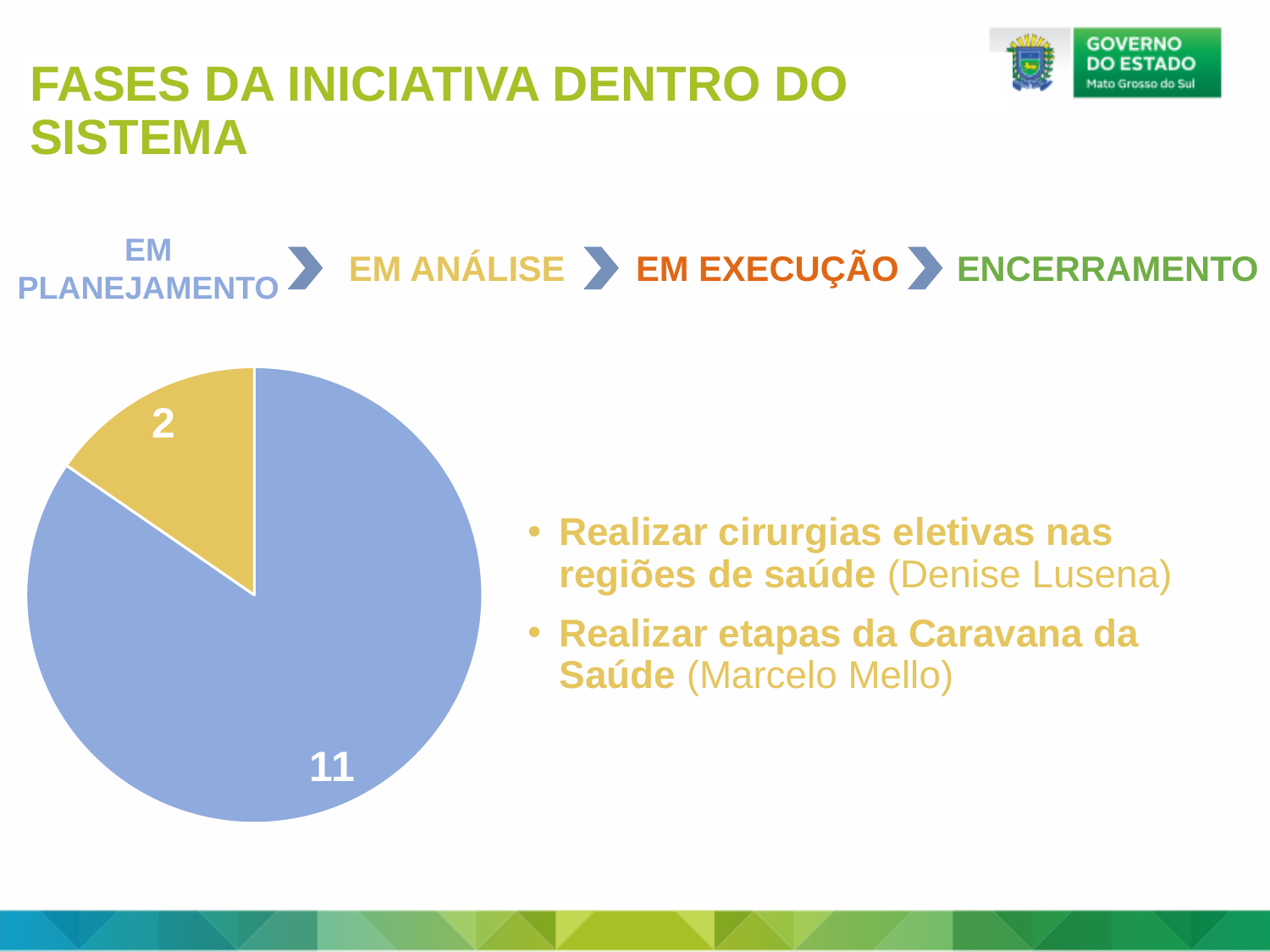
What value is printed on the blue slice of the pie chart? 11 Which slice of the pie chart is the largest? the blue slice (11) Which is larger, the blue slice or the yellow slice? the blue slice What is the difference between the values of the blue slice and the yellow slice? 9 Does the pie chart include a legend? No How many slices does the pie chart have? 2 Which slice of the pie chart is the smallest? the yellow slice (2) What value is printed on the yellow slice of the pie chart? 2 What kind of chart is shown on the slide? pie chart What is the total of the values shown on the pie chart? 13 What two colours are used for the slices of the pie chart? blue and yellow